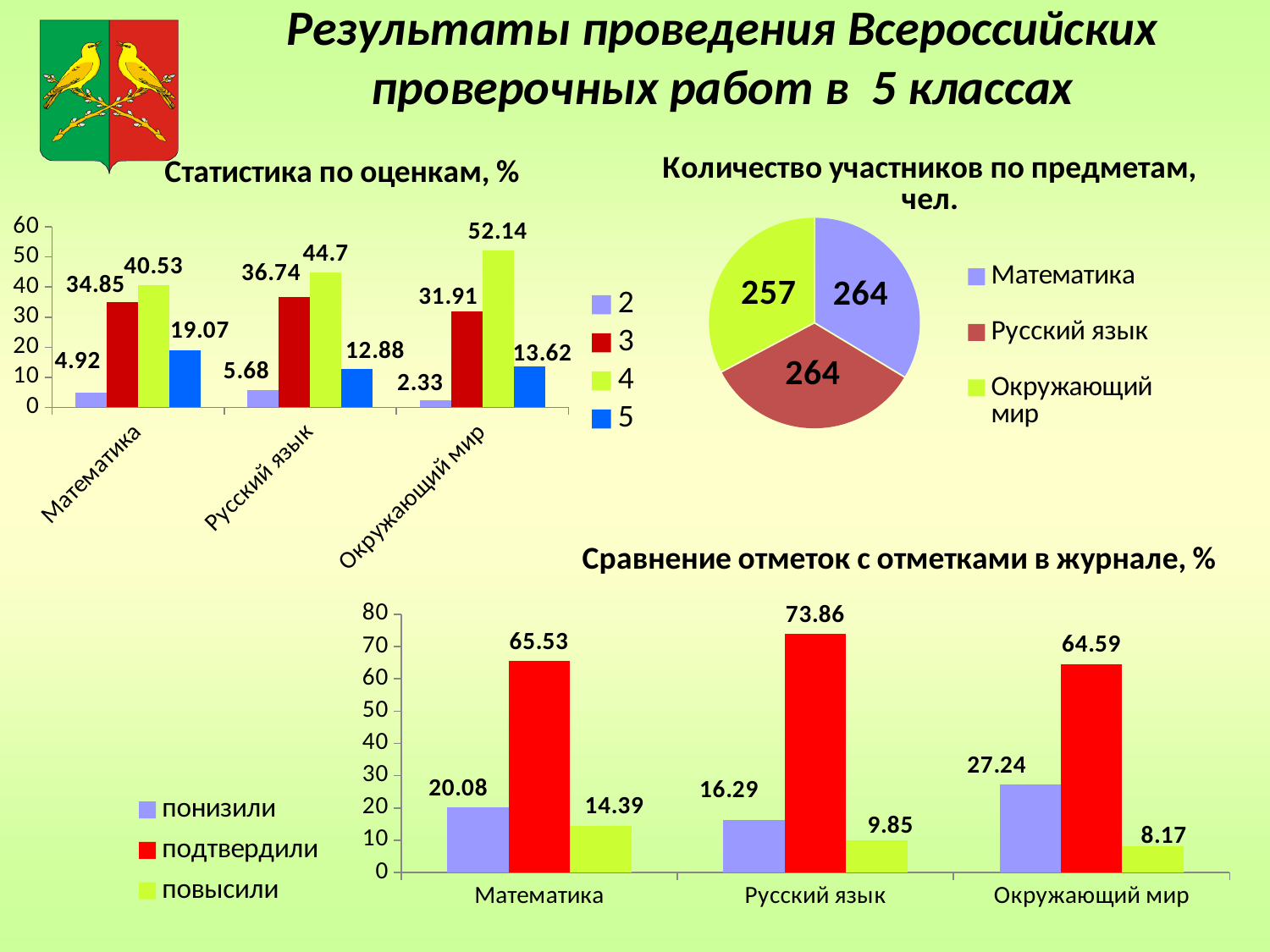
In the chart 'Сравнение отметок с отметками в журнале, %', what is the difference between 'понизили' for Окружающий мир and 'понизили' for Русский язык? 10.95 In the chart 'Сравнение отметок с отметками в журнале, %', which is larger for Математика: 'понизили' or 'повысили'? понизили In the pie chart 'Количество участников по предметам, чел.', how many participants are shown for Окружающий мир? 257 In the chart 'Статистика по оценкам, %', which subject has the highest value for grade 5? Математика What kind of chart is 'Количество участников по предметам, чел.'? pie chart In the chart 'Статистика по оценкам, %', what is the value for grade 4 in Окружающий мир? 52.14 In the chart 'Статистика по оценкам, %', how many series does the legend list? 4 In the chart 'Статистика по оценкам, %', what is the difference between the grade 4 and grade 3 values for Математика? 5.68 In the chart 'Сравнение отметок с отметками в журнале, %', which subject has the lowest value for 'повысили'? Окружающий мир In the pie chart 'Количество участников по предметам, чел.', how many slices are there? 3 In the chart 'Сравнение отметок с отметками в журнале, %', what is the value for 'подтвердили' in Русский язык? 73.86 In the chart 'Статистика по оценкам, %', what is the value for grade 2 in Русский язык? 5.68